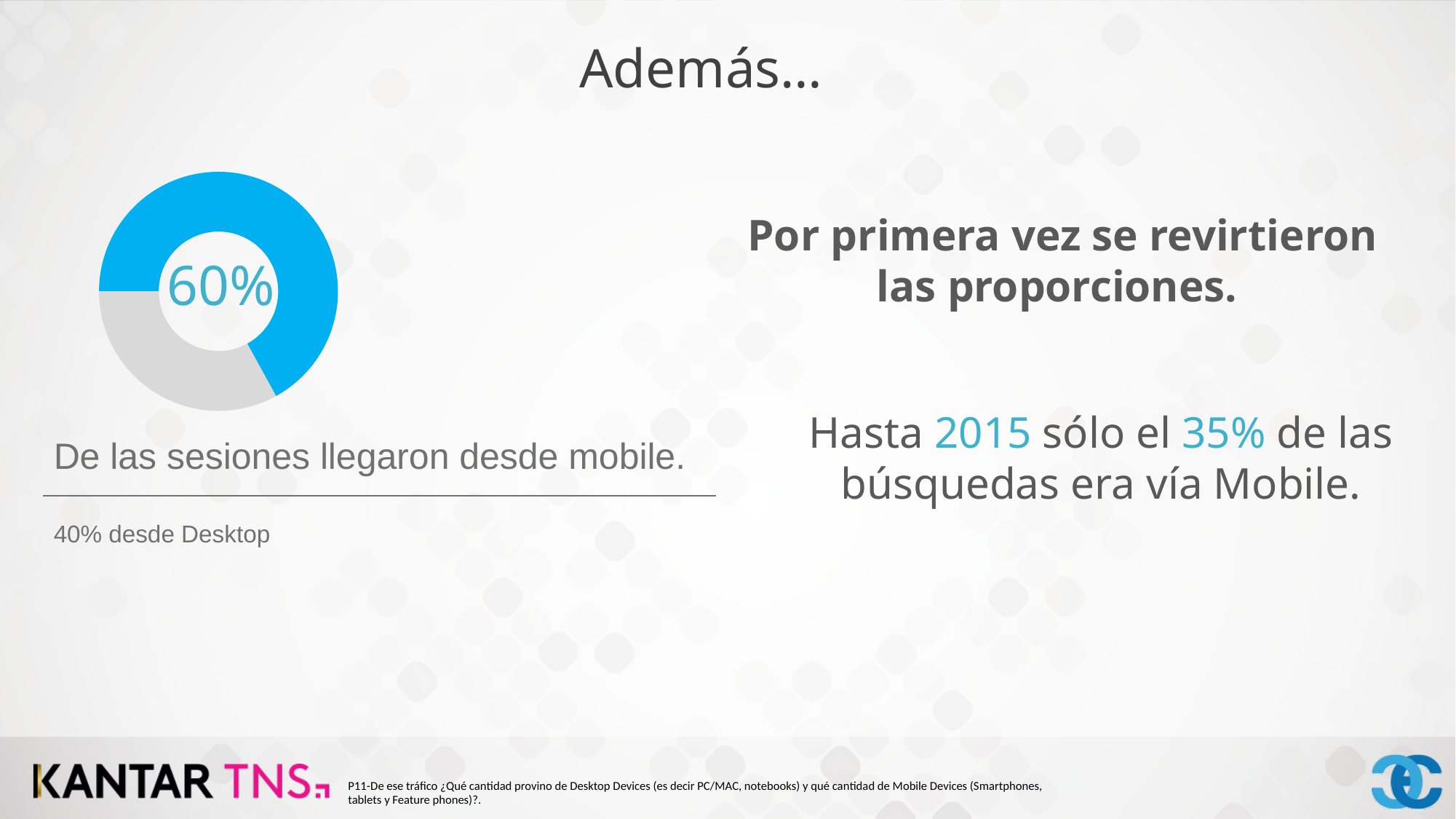
What percentage of sessions came from desktop according to the slide? 40% Which is larger in the chart, the mobile share or the desktop share? Mobile Is the mobile share shown in the chart greater or less than 50%? greater What kind of chart is shown on the slide? Doughnut chart What colour is the mobile (60%) segment of the doughnut chart? Blue Which segment of the doughnut chart is the largest? Mobile (60%) What is the difference between the mobile share and the desktop share shown on the slide? 20% What value is printed in the centre of the doughnut chart? 60% Which segment of the doughnut chart is the smallest? Desktop (40%) What percentage of sessions came from mobile according to the chart? 60% How many segments does the doughnut chart have? 2